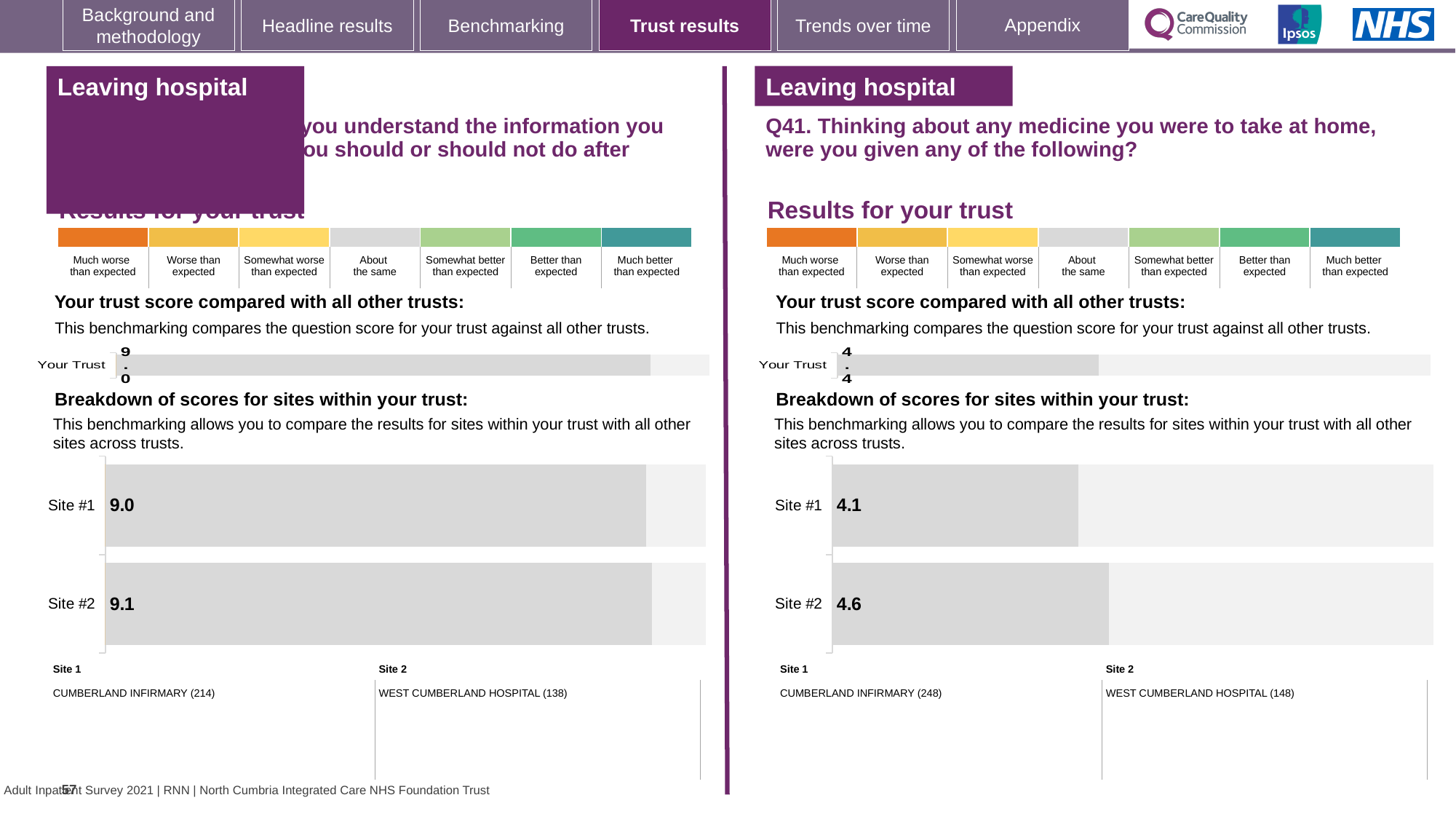
On the right-hand (Q41) site breakdown chart, what is the score for Site #2? 4.6 On the left-hand 'Your Trust' chart, what is the trust score shown? 9.0 On the left-hand site breakdown chart, what is the difference between the Site #2 and Site #1 scores? 0.1 On the right-hand (Q41) site breakdown chart, which site has the higher score? Site #2 On the right-hand (Q41) site breakdown chart, what is the difference between the Site #2 and Site #1 scores? 0.5 On the right-hand (Q41) site breakdown chart, which hospital is listed as Site 1? CUMBERLAND INFIRMARY (248) How many sites are shown on the right-hand (Q41) site breakdown chart? 2 On the right-hand (Q41) site breakdown chart, what is the score for Site #1? 4.1 On the right-hand (Q41) 'Your Trust' chart, what is the trust score shown? 4.4 What kind of chart is the right-hand (Q41) site breakdown chart? Bar chart On the left-hand site breakdown chart, what is the score for Site #1? 9.0 On the left-hand site breakdown chart, what is the score for Site #2? 9.1